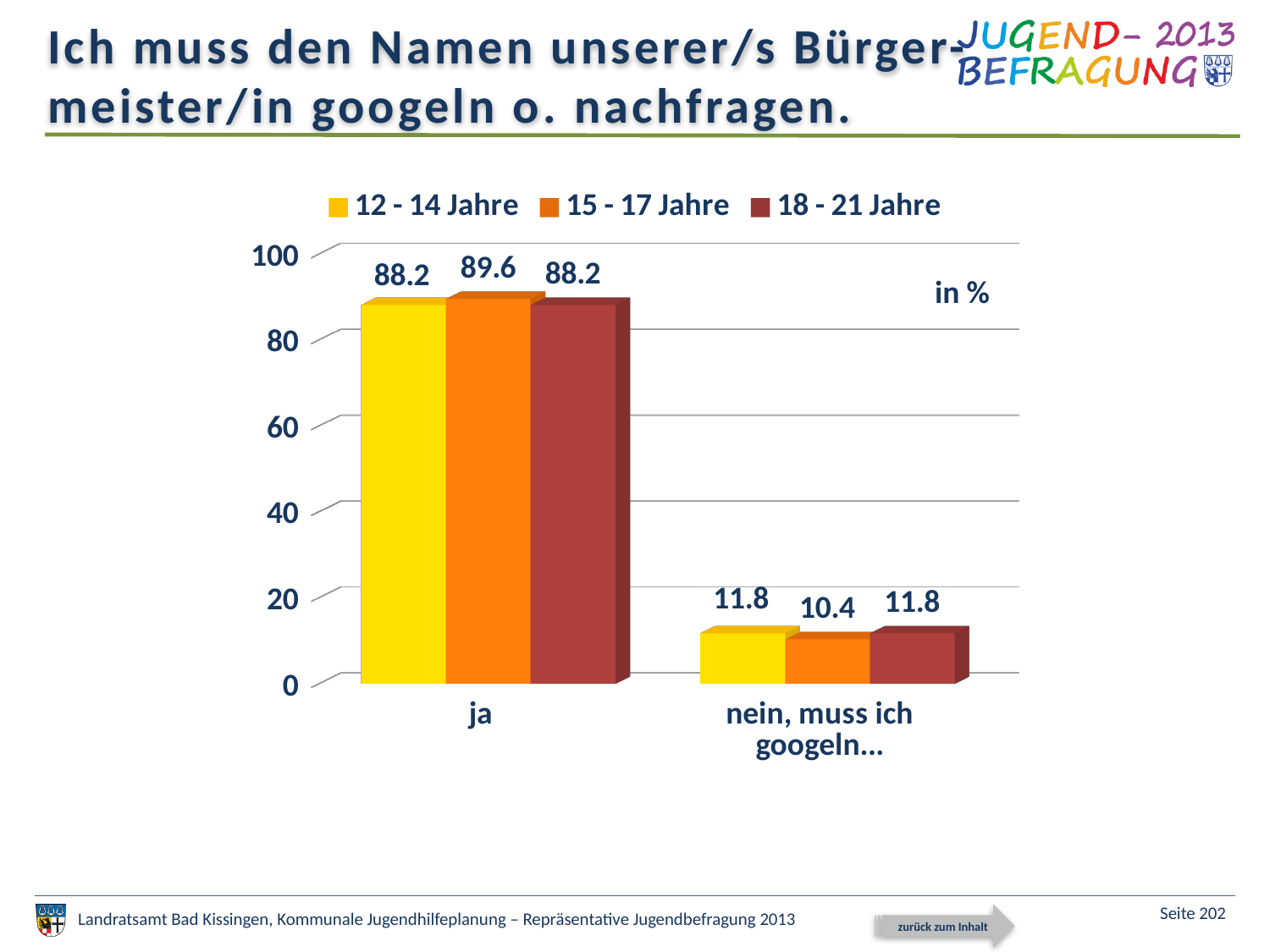
Which age group has the lowest value in the "nein, muss ich googeln..." category? 15 - 17 Jahre What is the value for the 15 - 17 Jahre series in the "ja" category? 89.6 What is the value for the 18 - 21 Jahre series in the "nein, muss ich googeln..." category? 11.8 How many categories are shown on the x axis? 2 Is the value for 18 - 21 Jahre in the "nein, muss ich googeln..." category greater or less than 20? less What is the difference between the 12 - 14 Jahre value and the 15 - 17 Jahre value in the "nein, muss ich googeln..." category? 1.4 What is the difference between the 15 - 17 Jahre value and the 12 - 14 Jahre value in the "ja" category? 1.4 What kind of chart is shown on the slide? bar chart Which age group has the highest value in the "ja" category? 15 - 17 Jahre Is the value for 15 - 17 Jahre in the "ja" category larger or smaller than the value for 15 - 17 Jahre in the "nein, muss ich googeln..." category? larger What is the value for the 12 - 14 Jahre series in the "ja" category? 88.2 How many series does the legend list? 3